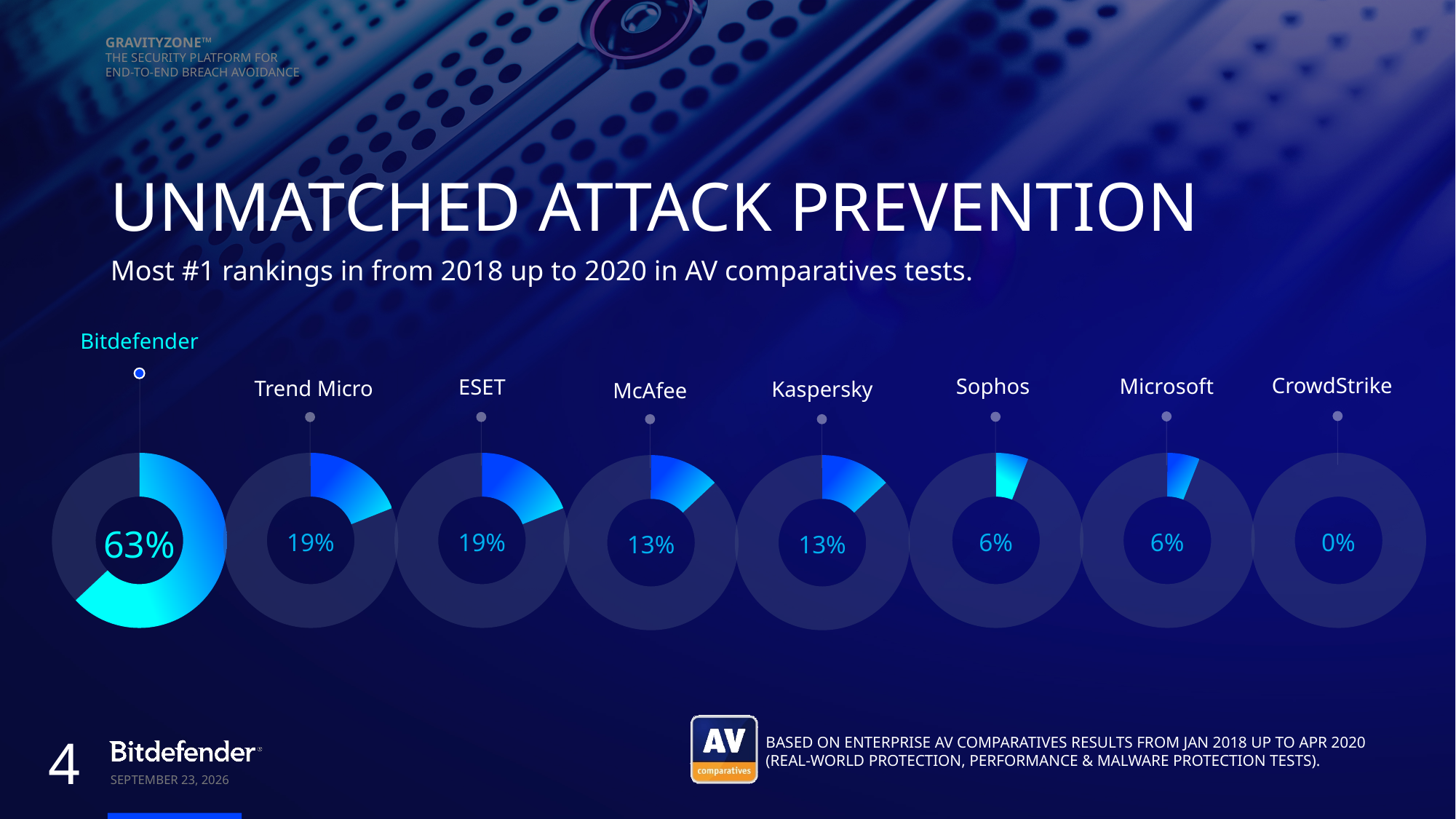
Which vendor has the highest percentage of #1 rankings? Bitdefender Which has a larger percentage, ESET or Kaspersky? ESET What percentage is shown for Bitdefender? 63% What percentage is shown for Trend Micro? 19% What is the difference between McAfee's percentage and Microsoft's percentage? 7% Which vendor has the lowest percentage of #1 rankings? CrowdStrike What percentage is shown for Sophos? 6% What kind of chart is used to show each vendor's percentage? Donut chart How many vendors are shown in the chart? 8 What percentage is shown for CrowdStrike? 0% What percentage is shown for Kaspersky? 13% What is the difference between Bitdefender's percentage and Trend Micro's percentage? 44%